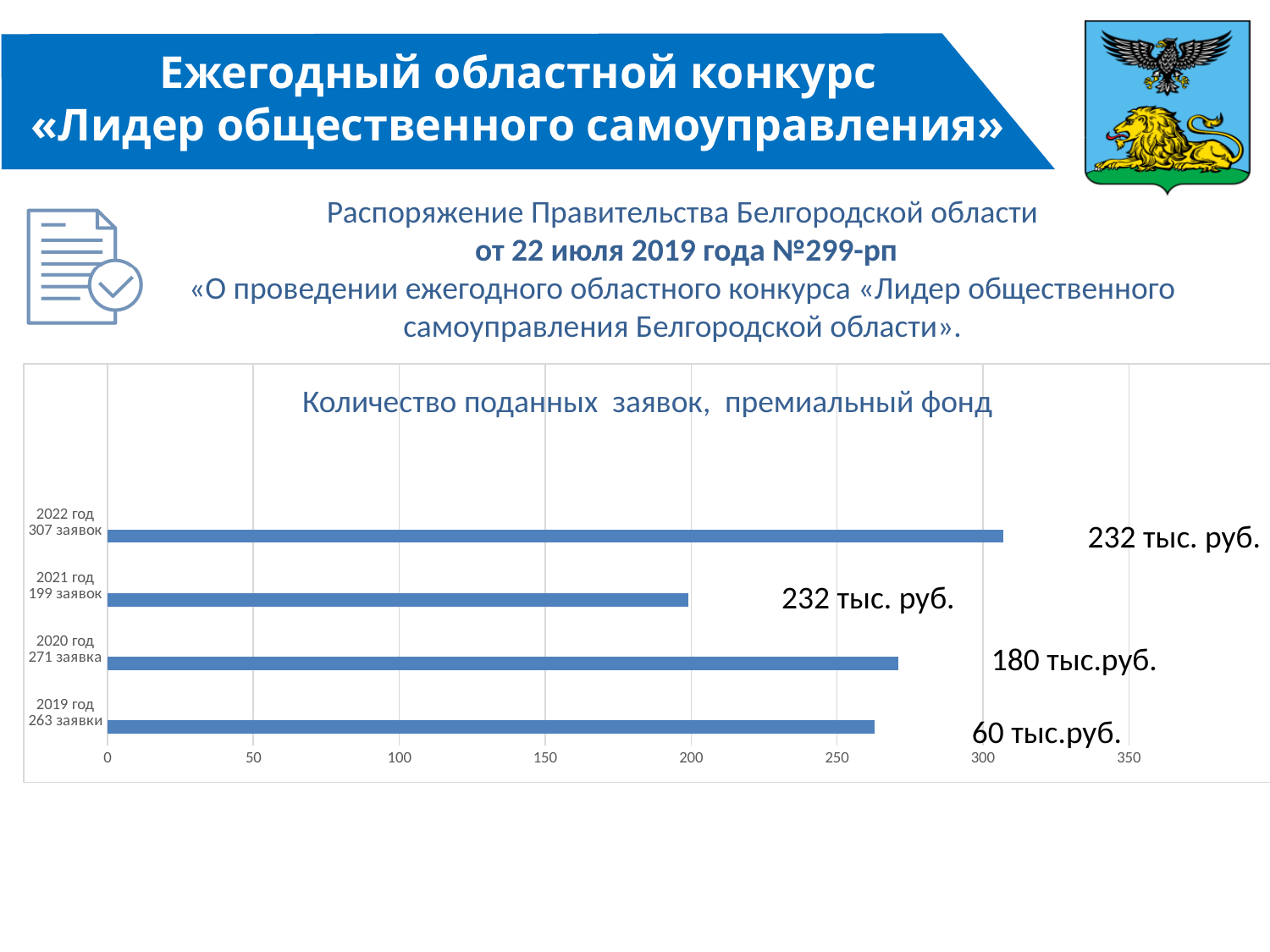
What is the title of the chart? Количество поданных заявок, премиальный фонд What is the difference between the number of applications in 2022 and in 2021? 108 How many applications (заявок) were submitted in 2022 according to the chart? 307 Which year has the highest number of submitted applications? 2022 год Is the value for 2021 greater or less than 250? less What kind of chart is shown on the slide? bar chart What premium fund (премиальный фонд) is shown next to the 2019 bar? 60 тыс.руб. Which year has the lowest number of submitted applications? 2021 год How many applications were submitted in 2021 according to the chart? 199 Which year had more applications, 2020 or 2019? 2020 год How many applications were submitted in 2020 according to the chart? 271 How many years (categories) are plotted in the chart? 4